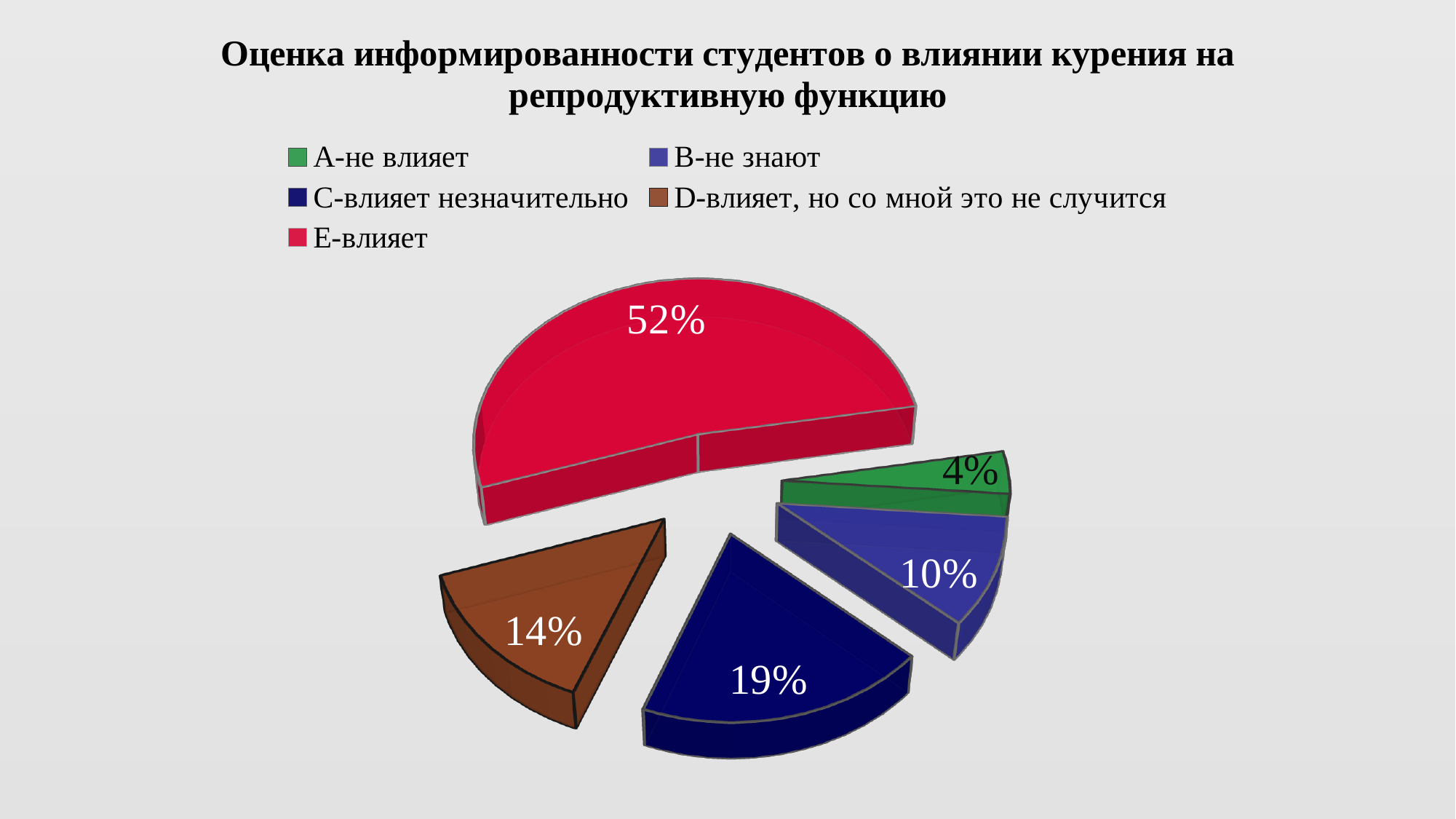
Which category has the largest slice? E-влияет Which category has the smallest slice? A-не влияет What share of the pie does the slice 'E-влияет' have? 52% Which is larger, the value for 'B-не знают' or the value for 'D-влияет, но со мной это не случится'? D-влияет, но со мной это не случится What is the value for 'A-не влияет'? 4% What colour is the slice for 'A-не влияет'? green What kind of chart is shown on the slide? pie chart What is the value for 'D-влияет, но со мной это не случится'? 14% What is the difference between the values for 'E-влияет' and 'C-влияет незначительно'? 33% How many categories does the pie chart have? 5 What is the value for 'B-не знают'? 10% What is the value for 'C-влияет незначительно'? 19%